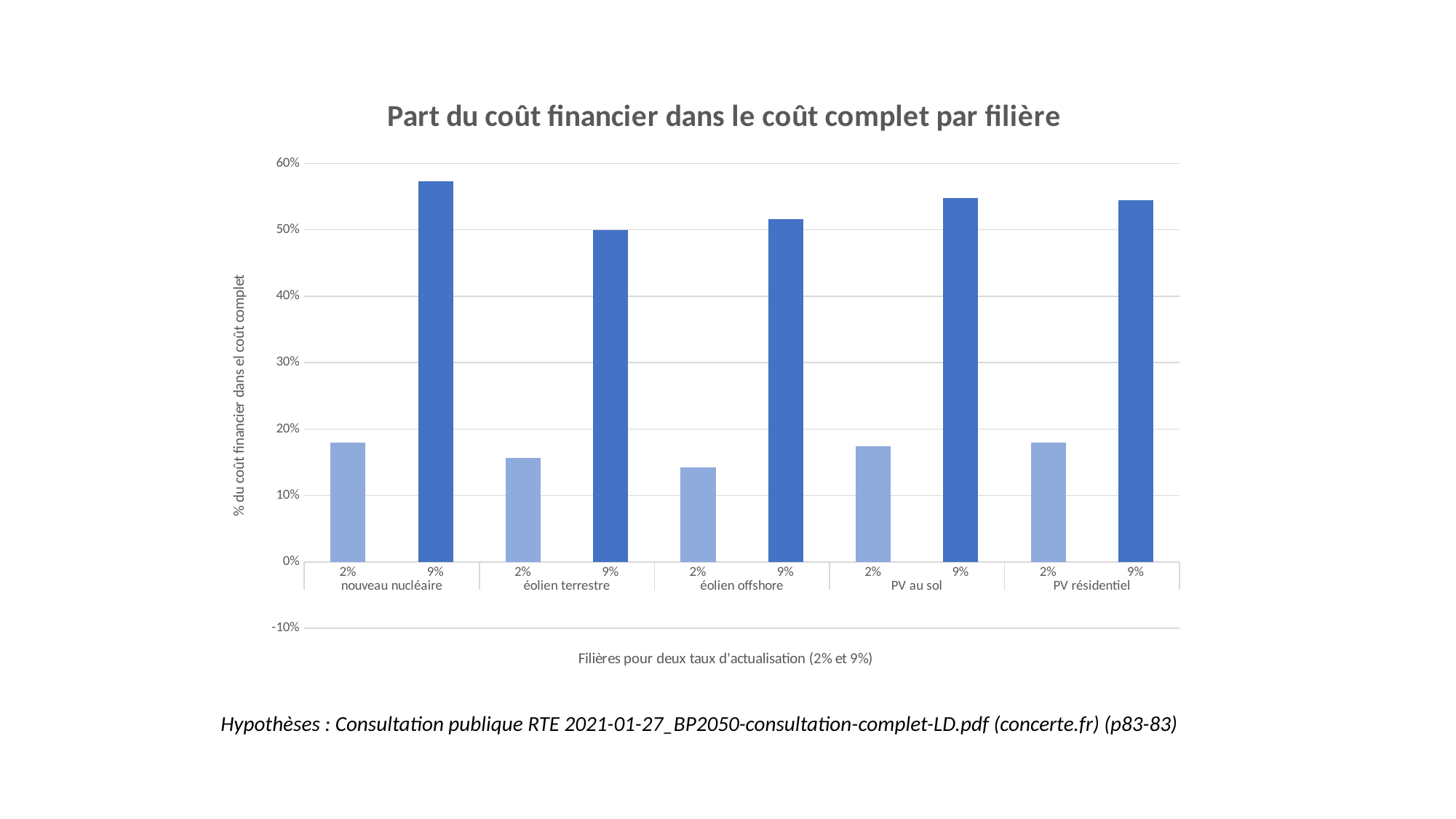
What is the label of the y axis? % du coût financier dans el coût complet Is the value for nouveau nucléaire at 2% greater or less than 20%? less Is the value for PV au sol at 9% greater or less than 50%? greater What kind of chart is shown on the slide? bar chart What is the title of the chart? Part du coût financier dans le coût complet par filière How many filières (categories) are shown on the x axis? 5 Which bar is the highest in the chart? nouveau nucléaire at 9% Is the value for éolien offshore at 2% greater or less than 20%? less Which is larger: the value for éolien offshore at 2% or the value for PV résidentiel at 2%? PV résidentiel at 2% How many bars are plotted in the chart in total? 10 Which bar is the lowest in the chart? éolien offshore at 2%